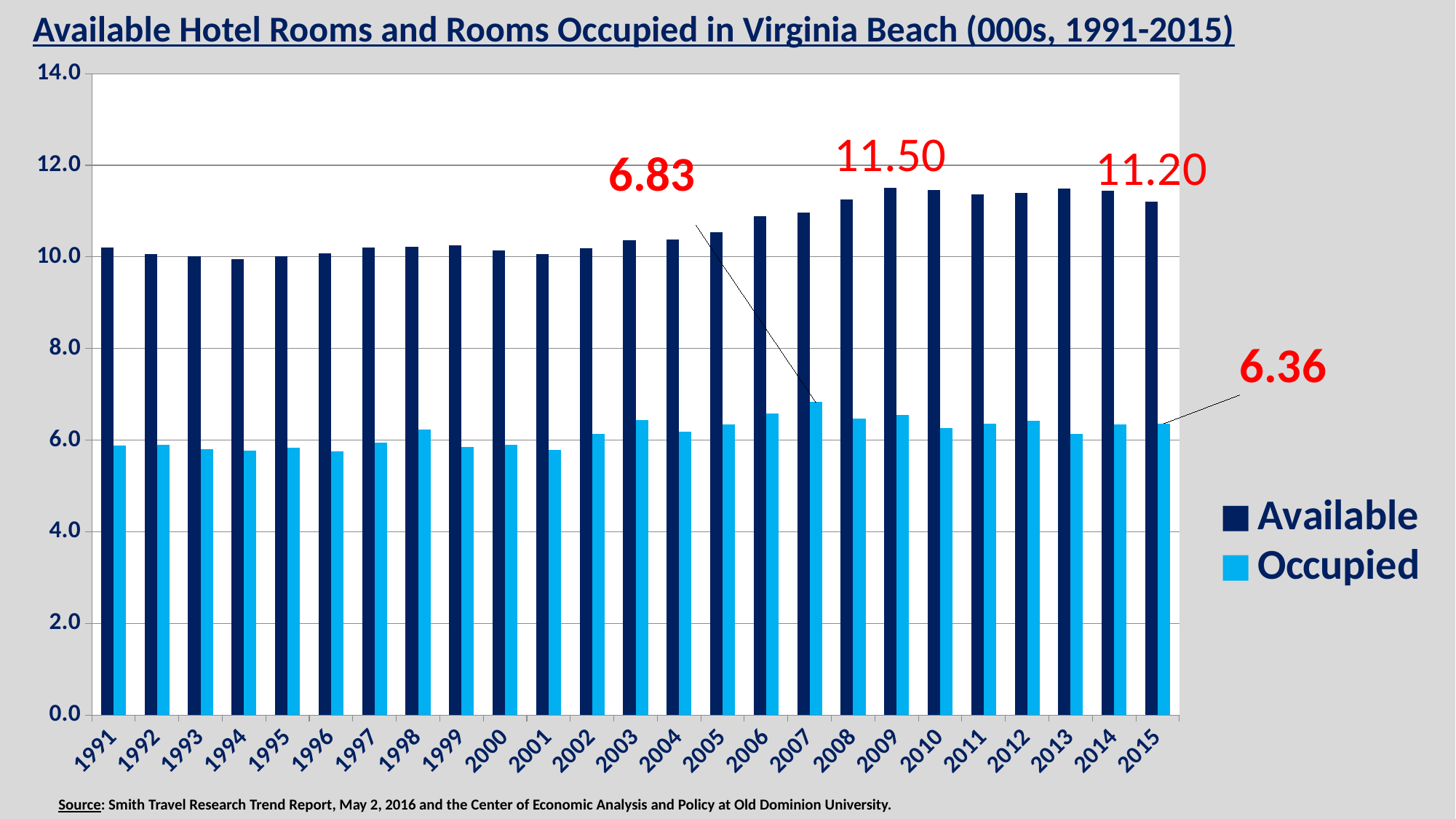
Which year has the highest value for Occupied rooms? 2007 How many years are shown on the x axis? 25 How many series does the legend list? 2 Is the value for Occupied rooms in 1996 greater or less than 6.0? less Which series is shown in dark blue in the legend? Available What kind of chart is shown on the slide? Bar chart By how much did Available rooms fall from 2009 to 2015? 0.30 What is the value of Available rooms in 2015? 11.20 What is the value of Occupied rooms in 2007? 6.83 What is the value of Occupied rooms in 2015? 6.36 What is the difference between Occupied rooms in 2007 and in 2015? 0.47 What is the value of Available rooms in 2009? 11.50